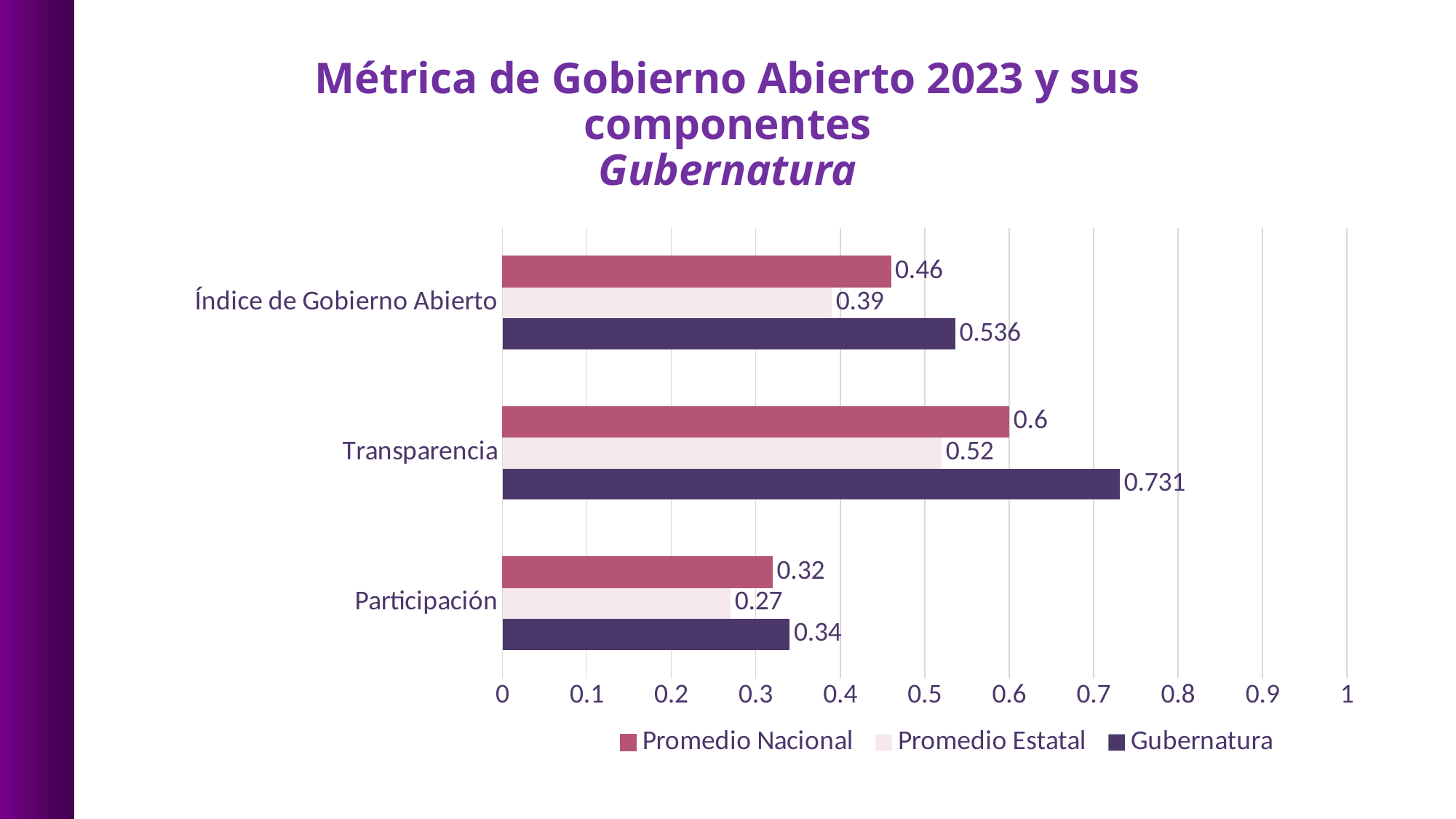
What is the difference between the Gubernatura and Promedio Nacional values for Índice de Gobierno Abierto? 0.076 What is the Promedio Estatal value for Índice de Gobierno Abierto? 0.39 Which series is shown in dark purple in the legend? Gubernatura How many series does the legend list? 3 Which category has the lowest Promedio Estatal value? Participación Which is larger for Transparencia: Promedio Nacional or Promedio Estatal? Promedio Nacional Is the Gubernatura value for Transparencia greater or less than 0.7? greater How many categories are shown on the chart? 3 What kind of chart is shown on the slide? Bar chart What is the Gubernatura value for Transparencia? 0.731 What is the Promedio Nacional value for Participación? 0.32 Which category has the highest Gubernatura value? Transparencia